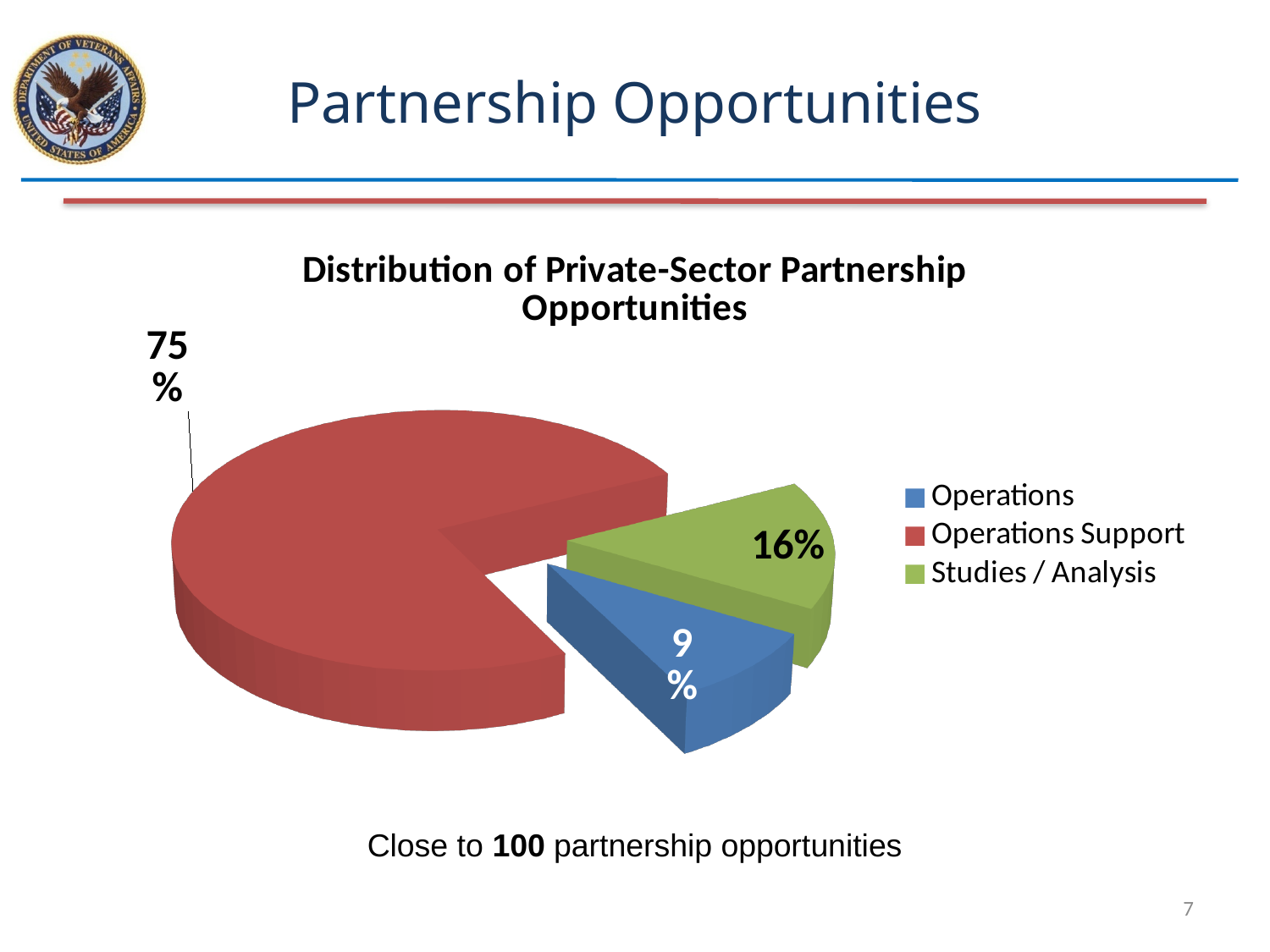
What percentage of the pie is Studies / Analysis? 16% What percentage of the pie is Operations Support? 75% Which is larger, the share for Studies / Analysis or the share for Operations? Studies / Analysis Which category has the smallest share of the pie? Operations What is the difference in percentage points between Operations Support and Studies / Analysis? 59 What percentage of the pie is Operations? 9% What is the title of the chart? Distribution of Private-Sector Partnership Opportunities How many categories does the legend list? 3 What type of chart is shown on the slide? Pie chart Which category has the largest share of the pie? Operations Support What is the difference in percentage points between Studies / Analysis and Operations? 7 What colour represents Operations Support in the chart? Red